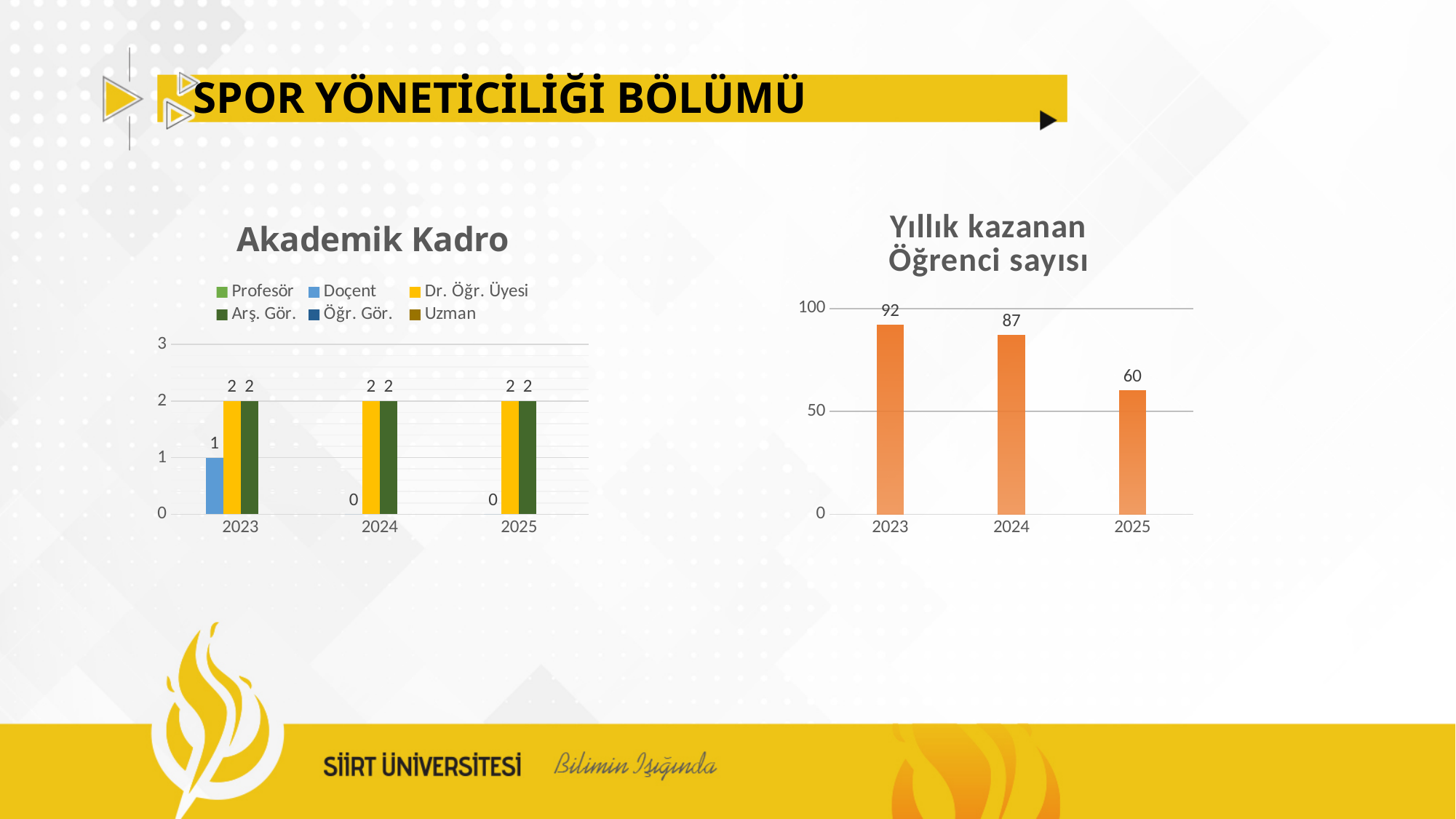
In the 'Akademik Kadro' chart, what is the value for Doçent in 2024? 0 In the 'Yıllık kazanan Öğrenci sayısı' chart, which year has the lowest value? 2025 In the 'Yıllık kazanan Öğrenci sayısı' chart, what is the value for 2023? 92 In the 'Yıllık kazanan Öğrenci sayısı' chart, what is the difference between the 2024 and 2025 values? 27 In the 'Akademik Kadro' chart, what is the value for Dr. Öğr. Üyesi in 2025? 2 What kind of chart is the 'Akademik Kadro' chart? bar chart In the 'Yıllık kazanan Öğrenci sayısı' chart, how many years are shown on the x axis? 3 In the 'Yıllık kazanan Öğrenci sayısı' chart, what is the value for 2025? 60 In the 'Akademik Kadro' chart, what is the value for Doçent in 2023? 1 In the 'Akademik Kadro' chart, how many series does the legend list? 6 In the 'Yıllık kazanan Öğrenci sayısı' chart, which year has the highest value? 2023 In the 'Yıllık kazanan Öğrenci sayısı' chart, do the values rise or fall from 2023 to 2025? fall